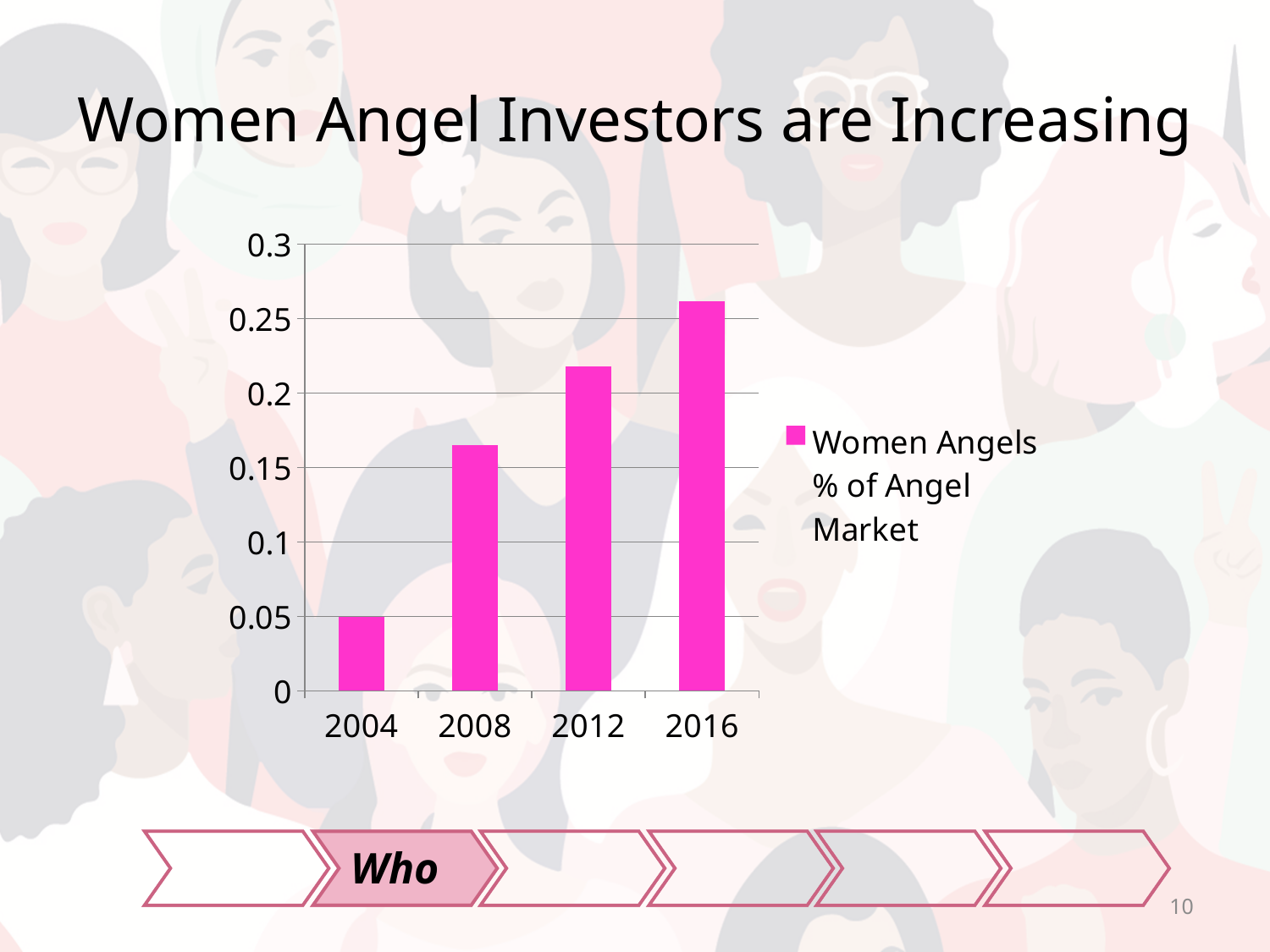
What kind of chart is shown on the slide? bar chart What series name does the chart's legend show? Women Angels % of Angel Market How many series does the chart's legend list? 1 Which year has the larger value, 2008 or 2012? 2012 Is the value for 2012 greater or less than 0.2? greater Is the value for 2004 greater or less than 0.1? less Is the value for 2016 greater or less than 0.25? greater How many years are shown on the x axis of the chart? 4 Which year has the highest value in the chart? 2016 Which year has the lowest value in the chart? 2004 Do the values rise or fall from 2004 to 2016? rise